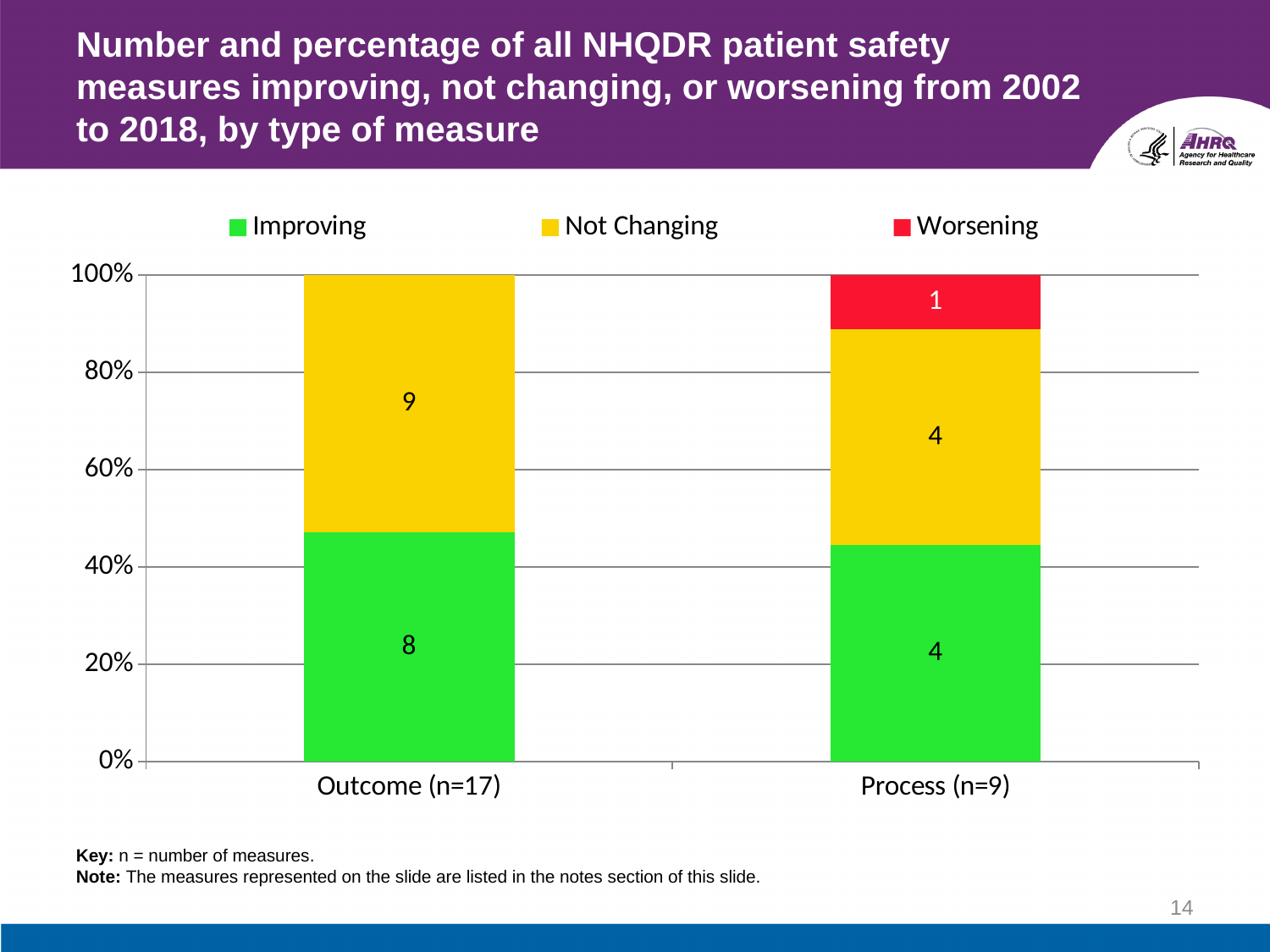
How many Outcome measures are Improving? 8 How many Process measures are Not Changing? 4 How many Outcome measures are Not Changing? 9 How many Process measures are Worsening? 1 What is the total number of measures in the Process bar? 9 Which series is shown in red in the legend? Worsening How many categories are shown on the x axis? 2 How many series does the legend list? 3 What is the difference between the number of Not Changing and Improving Outcome measures? 1 What kind of chart is shown on the slide? Stacked bar chart Is the Improving share of the Outcome bar greater or less than 40%? greater Which has more Improving measures, Outcome or Process? Outcome